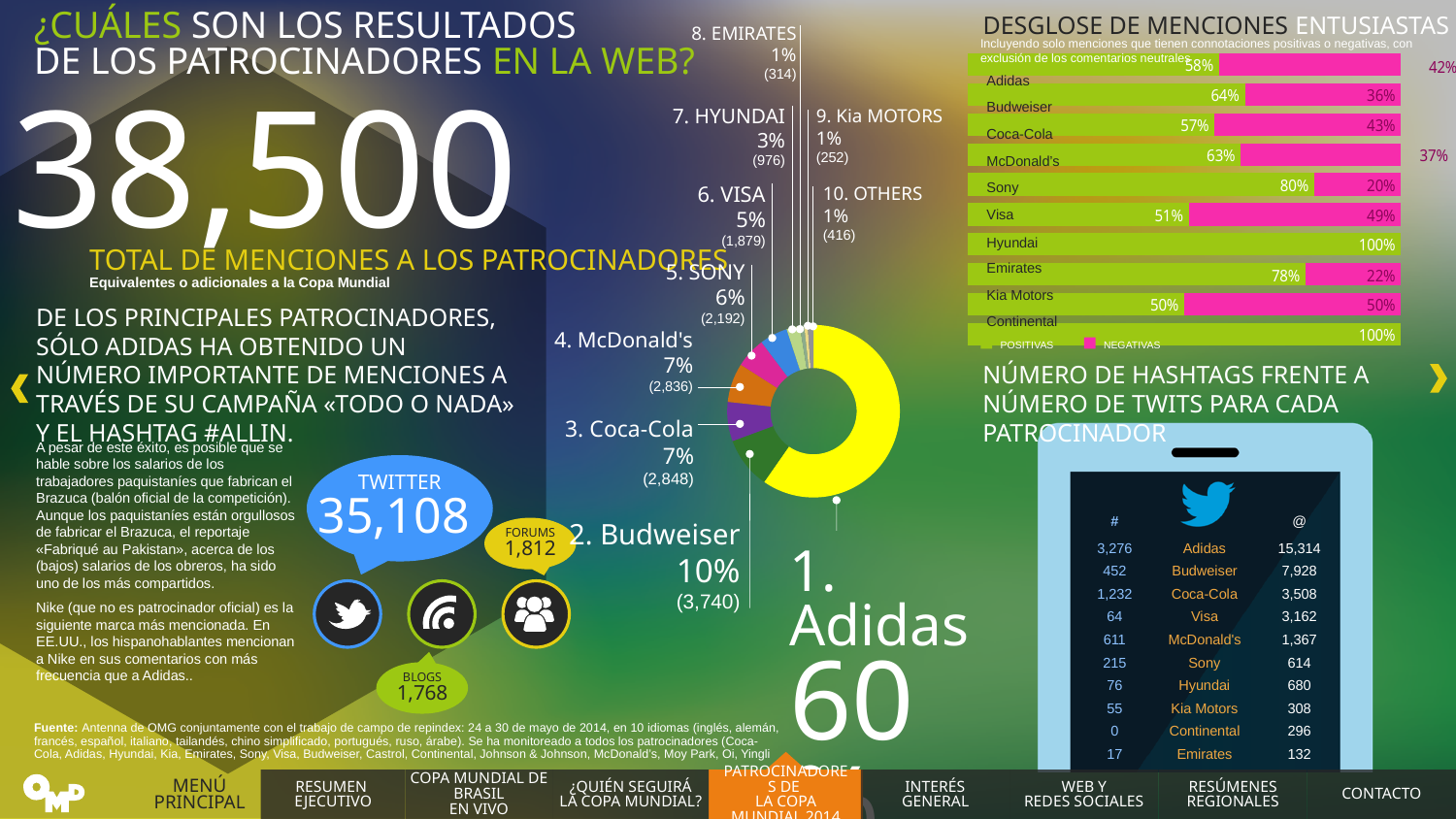
In the 'Desglose de menciones entusiastas' chart, which sponsor has the highest share of positive mentions? Sony In the 'Desglose de menciones entusiastas' chart, what percentage of Visa's mentions are negative? 49% In the donut chart of sponsor mentions, which sponsor has the largest share of mentions? Adidas In the 'Desglose de menciones entusiastas' chart, what percentage of Sony's mentions are positive? 80% How many segments are shown in the donut chart of sponsor mentions? 10 In the donut chart of sponsor mentions, which has more mentions, Hyundai or Emirates? Hyundai How many series does the legend of the 'Desglose de menciones entusiastas' chart list? 2 In the donut chart of sponsor mentions, what share of mentions does Budweiser have? 10% In the donut chart of sponsor mentions, how many mentions does Visa have? 1,879 In the donut chart of sponsor mentions, what is the difference in mentions between Budweiser and Sony? 1,548 In the donut chart of sponsor mentions, how many mentions does Coca-Cola have? 2,848 What type of chart is the 'Desglose de menciones entusiastas' chart? Stacked bar chart